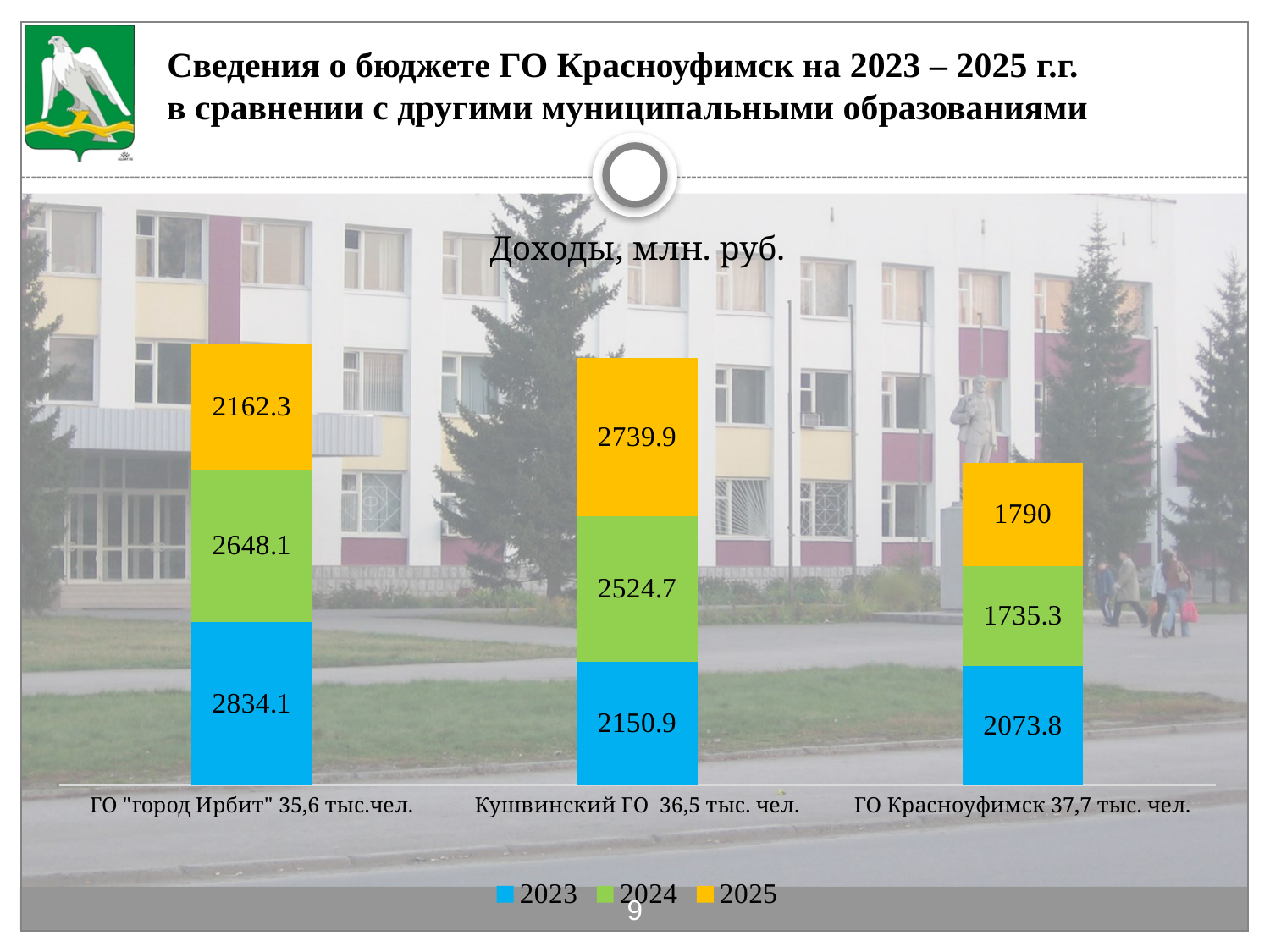
How many series does the legend list? 3 How many municipalities are shown on the chart? 3 What is the difference between the 2023 values for ГО "город Ирбит" and ГО Красноуфимск? 760.3 What is the 2024 value for Кушвинский ГО? 2524.7 Which is larger: the 2025 value for ГО "город Ирбит" or the 2025 value for Кушвинский ГО? Кушвинский ГО What is the total of the stacked bar for ГО Красноуфимск? 5599.1 Which municipality has the highest 2025 value? Кушвинский ГО What is the 2023 value for ГО "город Ирбит"? 2834.1 What is the total of the stacked bar for Кушвинский ГО? 7415.5 What type of chart is shown on the slide? Stacked bar chart What is the 2025 value for ГО Красноуфимск? 1790 Which municipality has the lowest 2024 value? ГО Красноуфимск